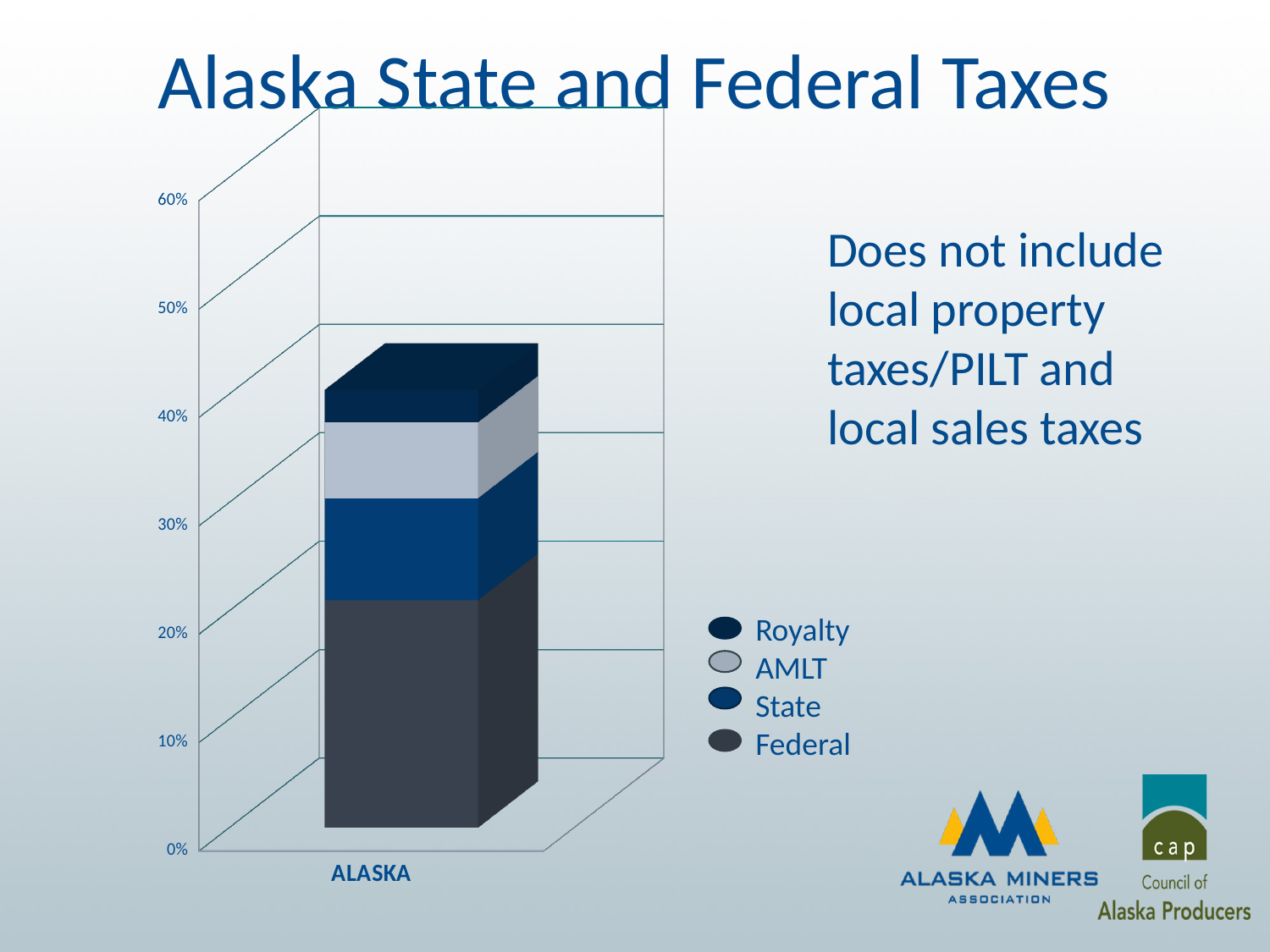
What kind of chart is shown on the slide? Stacked bar chart Which series forms the smallest segment of the ALASKA bar? Royalty What is the title of the chart slide? Alaska State and Federal Taxes What is the only category label on the x axis? ALASKA Which segment is larger in the ALASKA bar, AMLT or Royalty? AMLT Which segment is larger in the ALASKA bar, Federal or State? Federal Is the total height of the ALASKA stacked bar greater or less than 30%? greater Is the total height of the ALASKA stacked bar greater or less than 50%? less How many series does the legend list? 4 Which series forms the largest segment of the ALASKA bar? Federal Is the Federal segment of the ALASKA bar greater or less than 10%? greater How many categories are shown on the x axis? 1